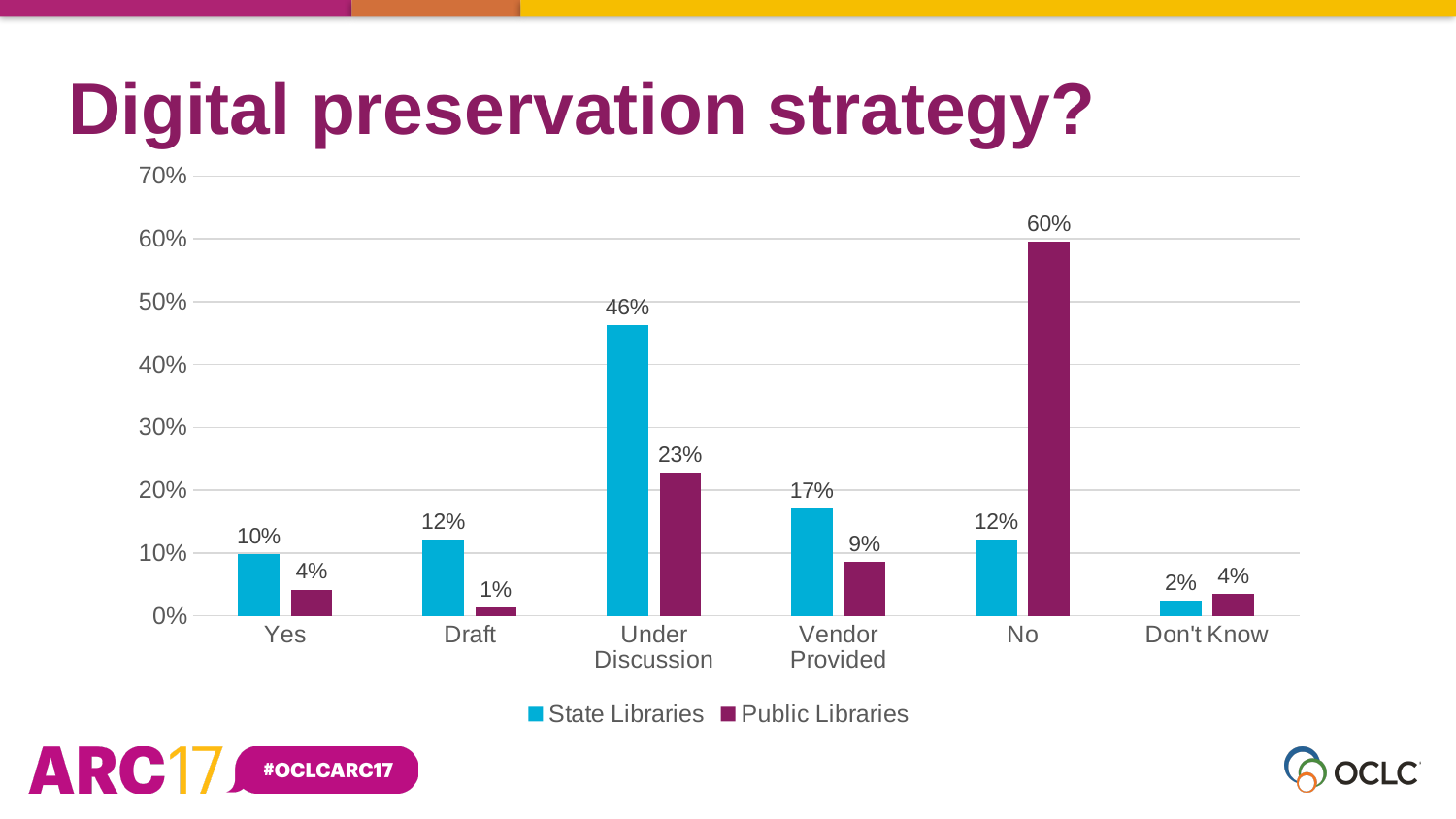
What percentage of State Libraries answered "Under Discussion"? 46% Which category has the highest value for State Libraries? Under Discussion Which category has the lowest value for Public Libraries? Draft What is the value for Public Libraries in the "Draft" category? 1% Which is larger for "Vendor Provided": State Libraries or Public Libraries? State Libraries What is the title of the slide? Digital preservation strategy? What kind of chart is shown on the slide? Bar chart What is the difference between the Public Libraries and State Libraries values for "No"? 48% What percentage of Public Libraries answered "No"? 60% Is the value for Public Libraries in "Under Discussion" greater or less than 20%? greater How many categories are shown on the x axis? 6 How many series does the legend list? 2